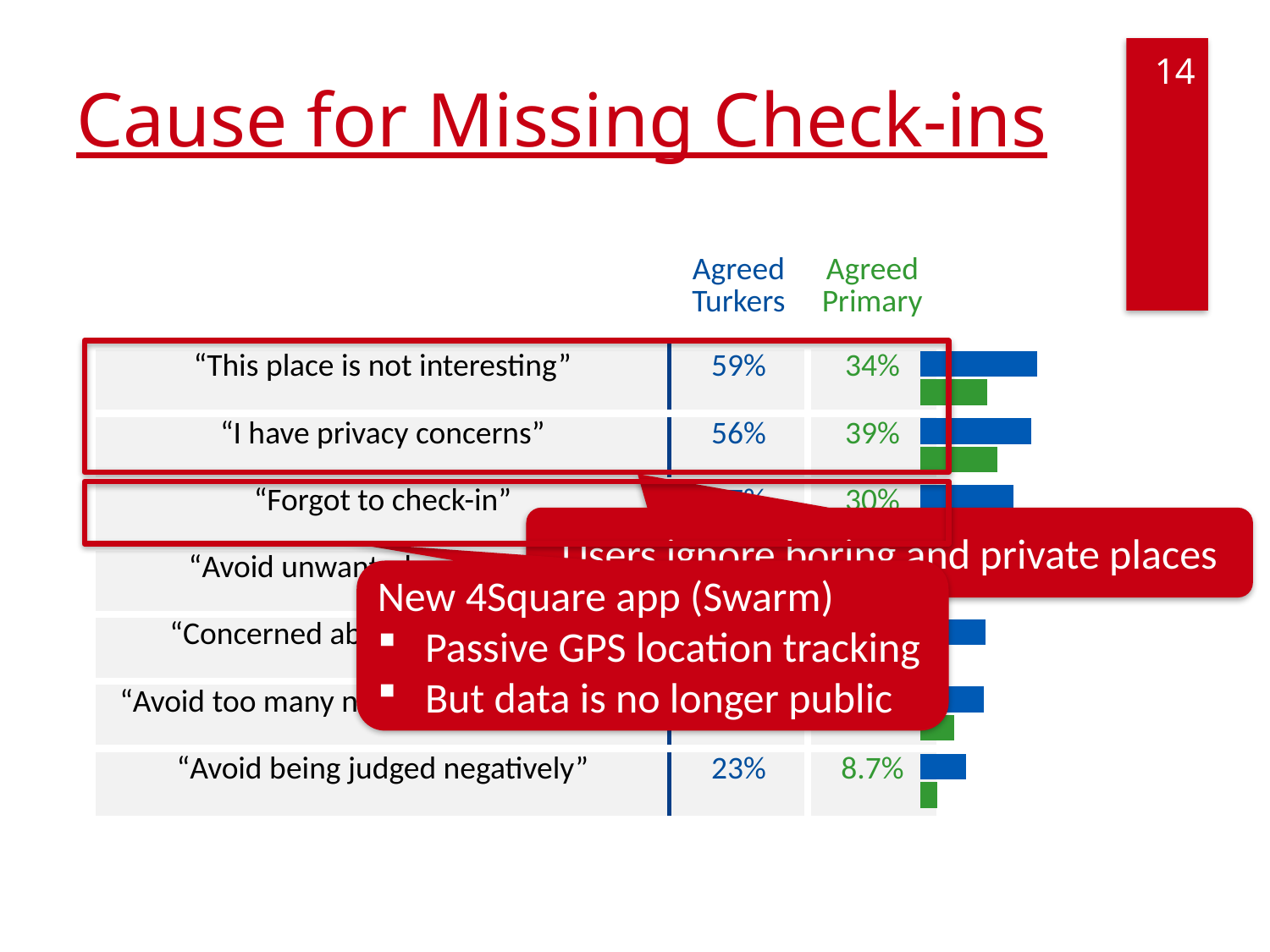
What kind of chart is used to visualise the agreement percentages next to the table? Bar chart What percentage of Primary users agreed with "Forgot to check-in"? 30% What percentage of Turkers agreed with "This place is not interesting"? 59% What percentage of Primary users agreed with "I have privacy concerns"? 39% Which group had a higher agreement rate for "I have privacy concerns", Turkers or Primary? Turkers What is the difference between the Agreed Turkers and Agreed Primary values for "I have privacy concerns"? 17% What percentage of Primary users agreed with "Avoid being judged negatively"? 8.7% What percentage of Turkers agreed with "I have privacy concerns"? 56% What percentage of Turkers agreed with "Avoid being judged negatively"? 23% What percentage of Primary users agreed with "This place is not interesting"? 34% What is the difference between the Agreed Turkers and Agreed Primary values for "This place is not interesting"? 25% Which of the two groups, Turkers or Primary, is shown with blue bars? Turkers